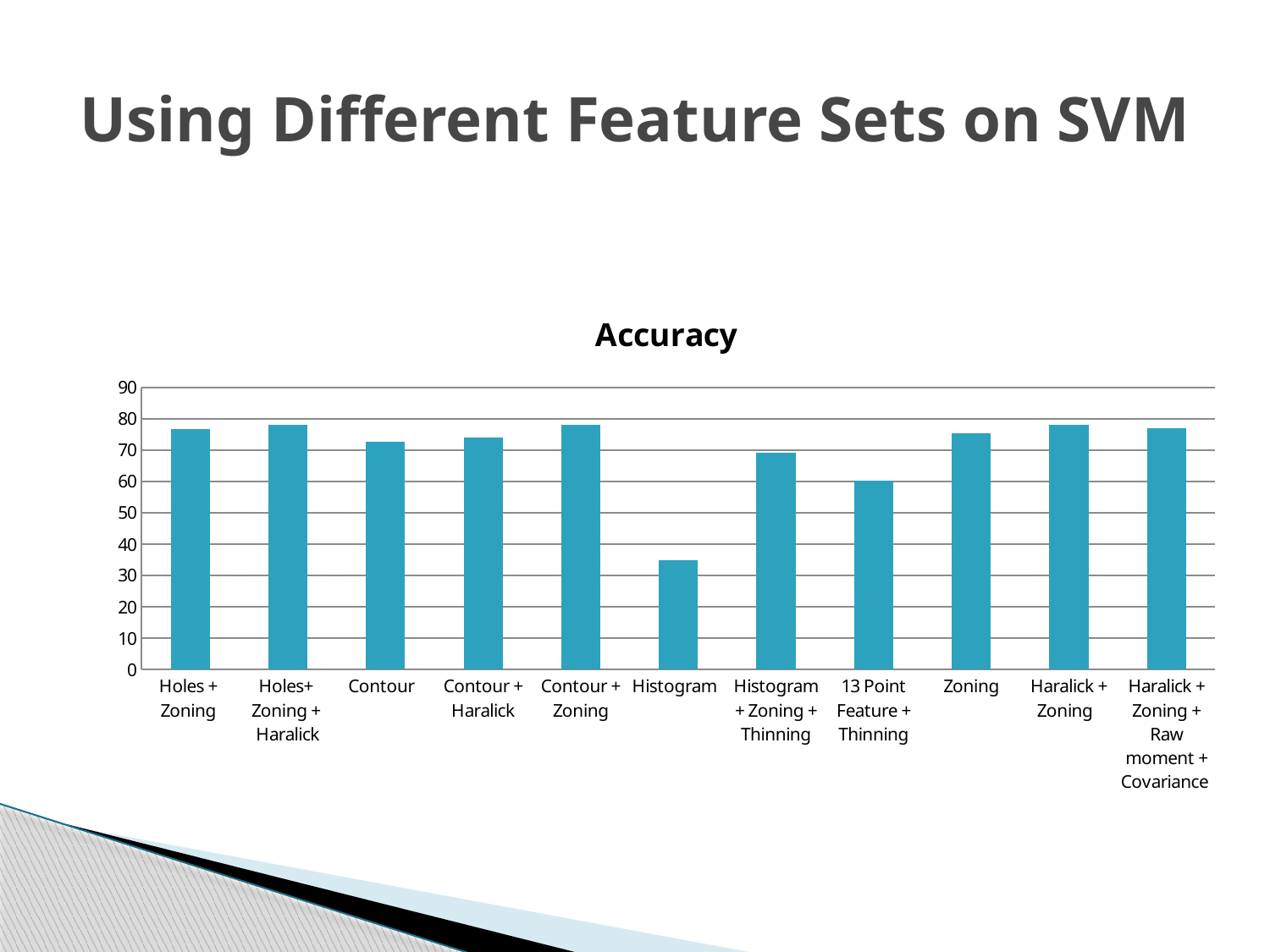
Which has the higher accuracy, Histogram + Zoning + Thinning or Holes + Zoning? Holes + Zoning Is the value for Histogram greater or less than 40? less Is the value for Contour greater or less than 70? greater What is the highest value shown on the y axis? 90 Is the value for Histogram + Zoning + Thinning greater or less than 60? greater Which has the higher accuracy, Histogram or Zoning? Zoning What type of chart is shown on the slide? bar chart Which has the higher accuracy, 13 Point Feature + Thinning or Contour? Contour Which feature set has the lowest accuracy? Histogram What is the title of the chart? Accuracy How many feature-set categories are plotted on the x axis? 11